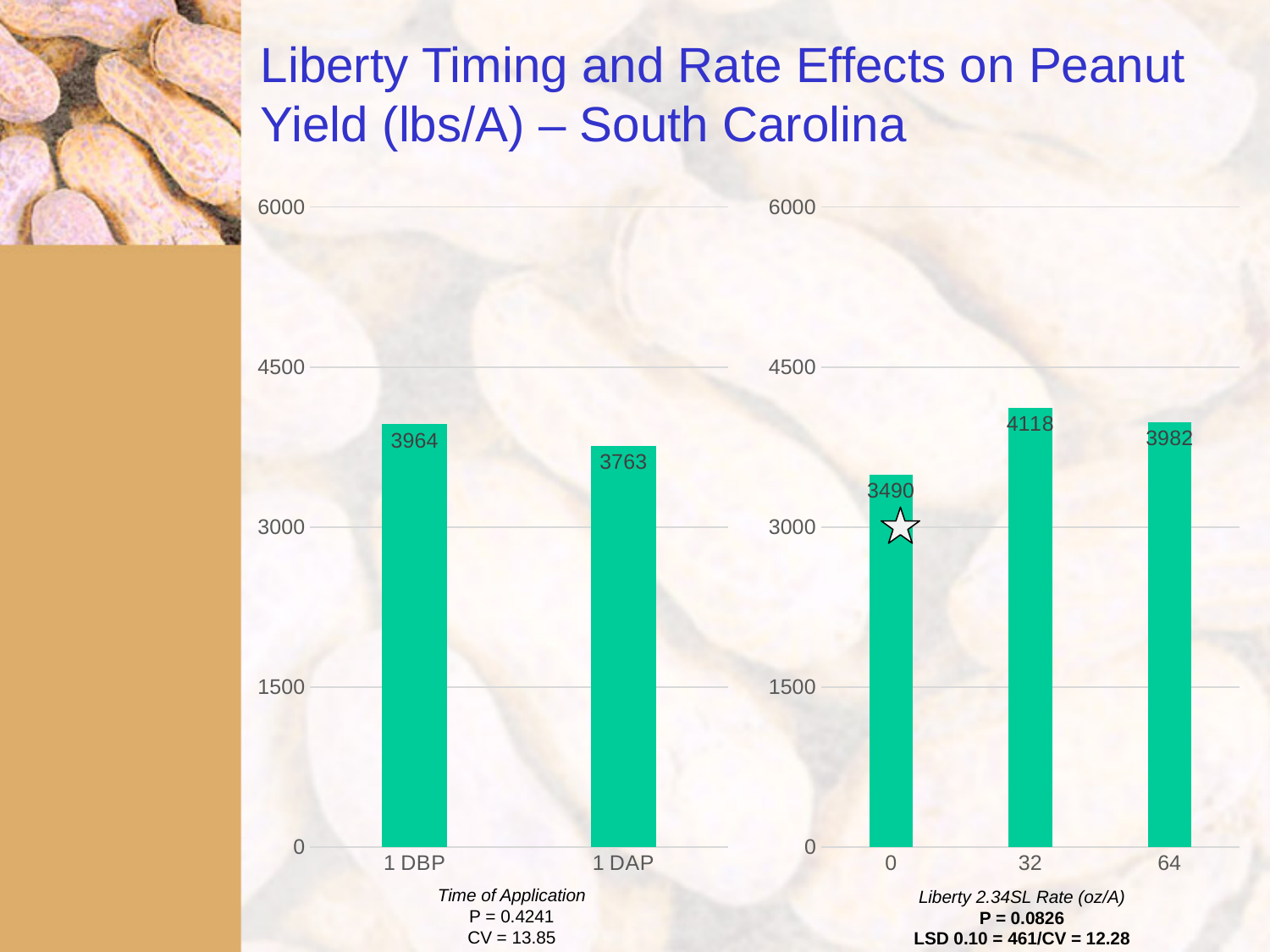
In the left chart (Time of Application), what is the yield for 1 DAP? 3763 In the right chart (Liberty 2.34SL Rate), which rate has the lowest yield? 0 In the left chart (Time of Application), what is the difference between the 1 DBP and 1 DAP yields? 201 In the right chart (Liberty 2.34SL Rate), which rate has the highest yield? 32 What kind of chart is used on this slide? Bar chart In the right chart (Liberty 2.34SL Rate), what is the yield at the 32 oz/A rate? 4118 In the right chart (Liberty 2.34SL Rate), what is the yield at the 0 oz/A rate? 3490 In the left chart (Time of Application), how many bars are plotted? 2 In the right chart (Liberty 2.34SL Rate), what is the yield at the 64 oz/A rate? 3982 In the left chart (Time of Application), what is the yield for 1 DBP? 3964 In the right chart (Liberty 2.34SL Rate), what is the difference between the yields at 32 and 0 oz/A? 628 In the left chart (Time of Application), which category has the higher yield? 1 DBP